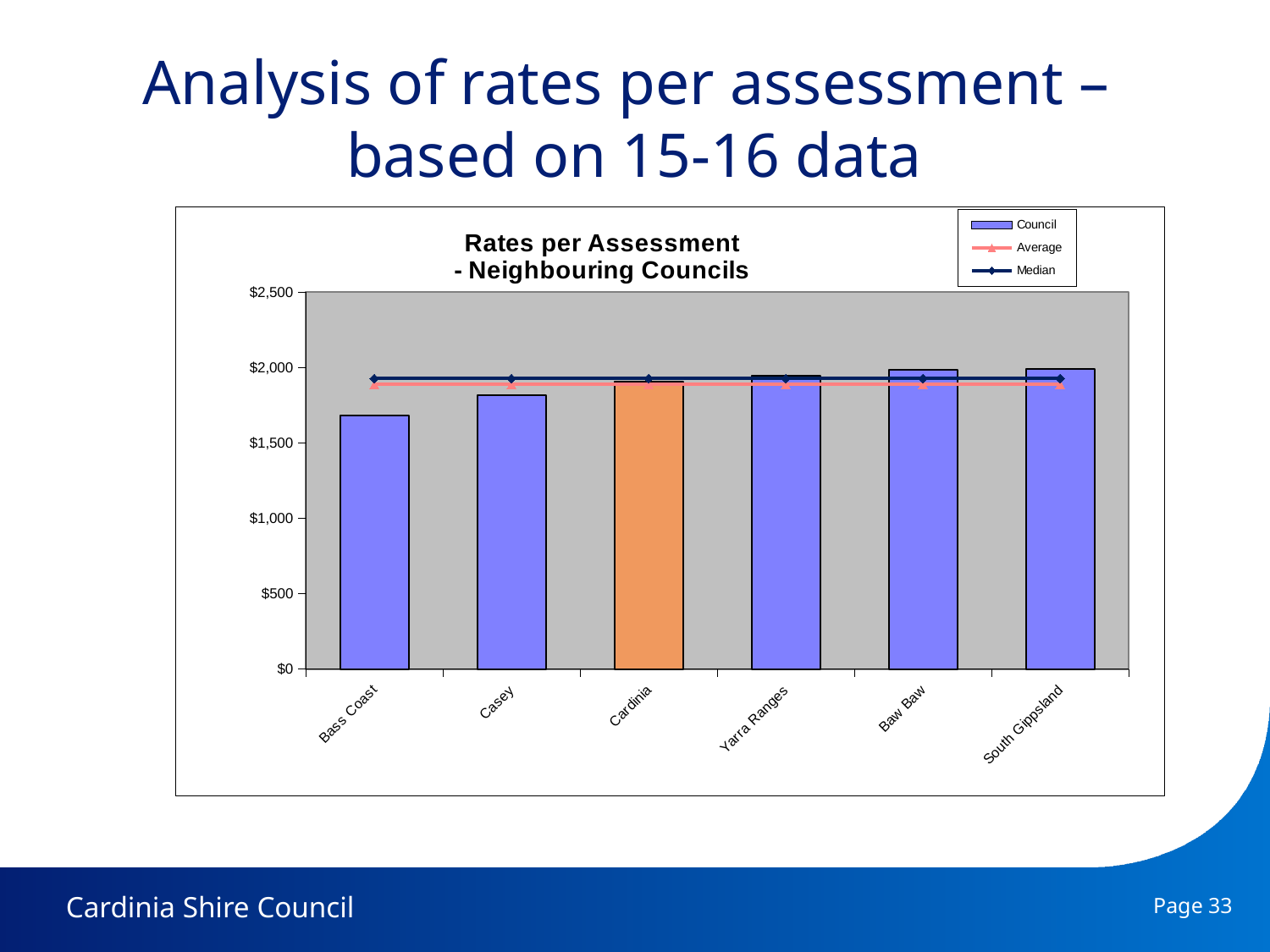
Do the bar values generally rise or fall from left to right across the councils? rise Which council's bar is coloured orange instead of blue? Cardinia Which is larger, the rates per assessment for Casey or for Bass Coast? Casey Which council has the lowest rates per assessment? Bass Coast What kind of chart is shown on the slide? bar chart How many series does the chart's legend list? 3 How many councils are shown on the x axis of the chart? 6 Is the value for Bass Coast greater or less than $2,000? less Is the value for Casey greater or less than $2,000? less Is the value for Bass Coast greater or less than $1,500? greater What is the title of the chart? Rates per Assessment - Neighbouring Councils